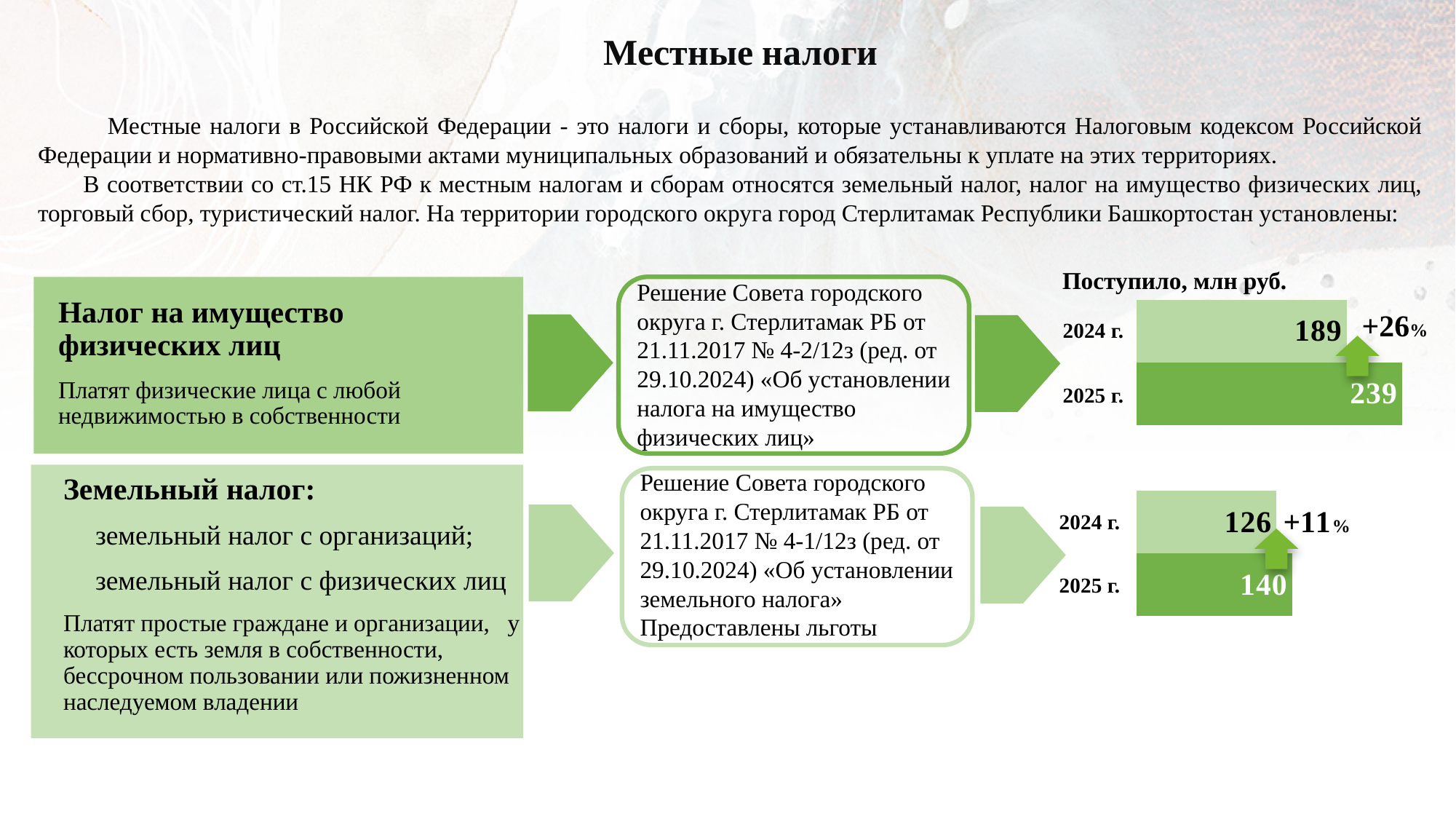
In what units are the receipts in the charts expressed, according to the heading above them? млн руб. In the bar chart for the land tax (lower chart), what amount was received in 2025? 140 What percentage growth is shown next to the upper chart (property tax on individuals)? +26% In the bar chart for the land tax (lower chart), what amount was received in 2024? 126 In the bar chart for the property tax on individuals (upper chart), what amount was received in 2025? 239 In the upper chart (property tax on individuals), which year has the higher receipts? 2025 г. What type of chart is used to show the receipts for each tax? bar chart Is the 2025 value in the upper chart (property tax) larger or smaller than the 2025 value in the lower chart (land tax)? larger In the lower chart (land tax), what is the difference between the 2025 and 2024 receipts? 14 In the lower chart (land tax), which year has the lower receipts? 2024 г. In the upper chart (property tax on individuals), by how much did receipts in 2025 exceed those in 2024? 50 In the bar chart for the property tax on individuals (upper chart), what amount was received in 2024? 189